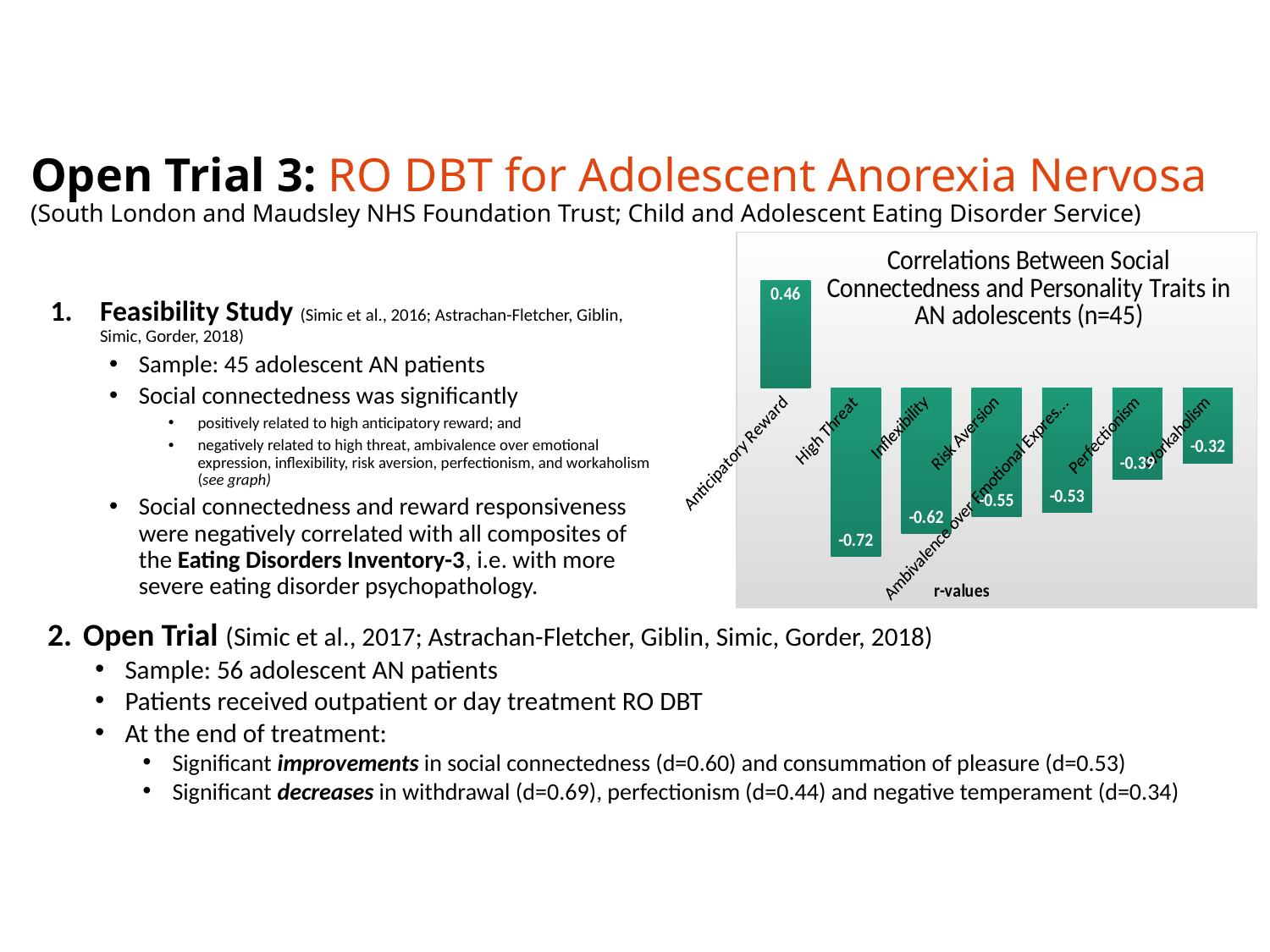
How many personality traits are plotted in the chart? 7 What is the r-value shown for Anticipatory Reward? 0.46 What kind of chart is used to show the correlations? Bar chart What is the r-value shown for Inflexibility? -0.62 What is the r-value shown for High Threat? -0.72 What is the difference between the r-values for High Threat and Workaholism? 0.40 Which personality trait has the highest (most positive) r-value in the chart? Anticipatory Reward Which personality trait has the lowest (most negative) r-value in the chart? High Threat Which has a larger r-value, Risk Aversion or Perfectionism? Perfectionism What is the r-value shown for Perfectionism? -0.39 What is the title of the chart? Correlations Between Social Connectedness and Personality Traits in AN adolescents (n=45) What is the r-value shown for Workaholism? -0.32